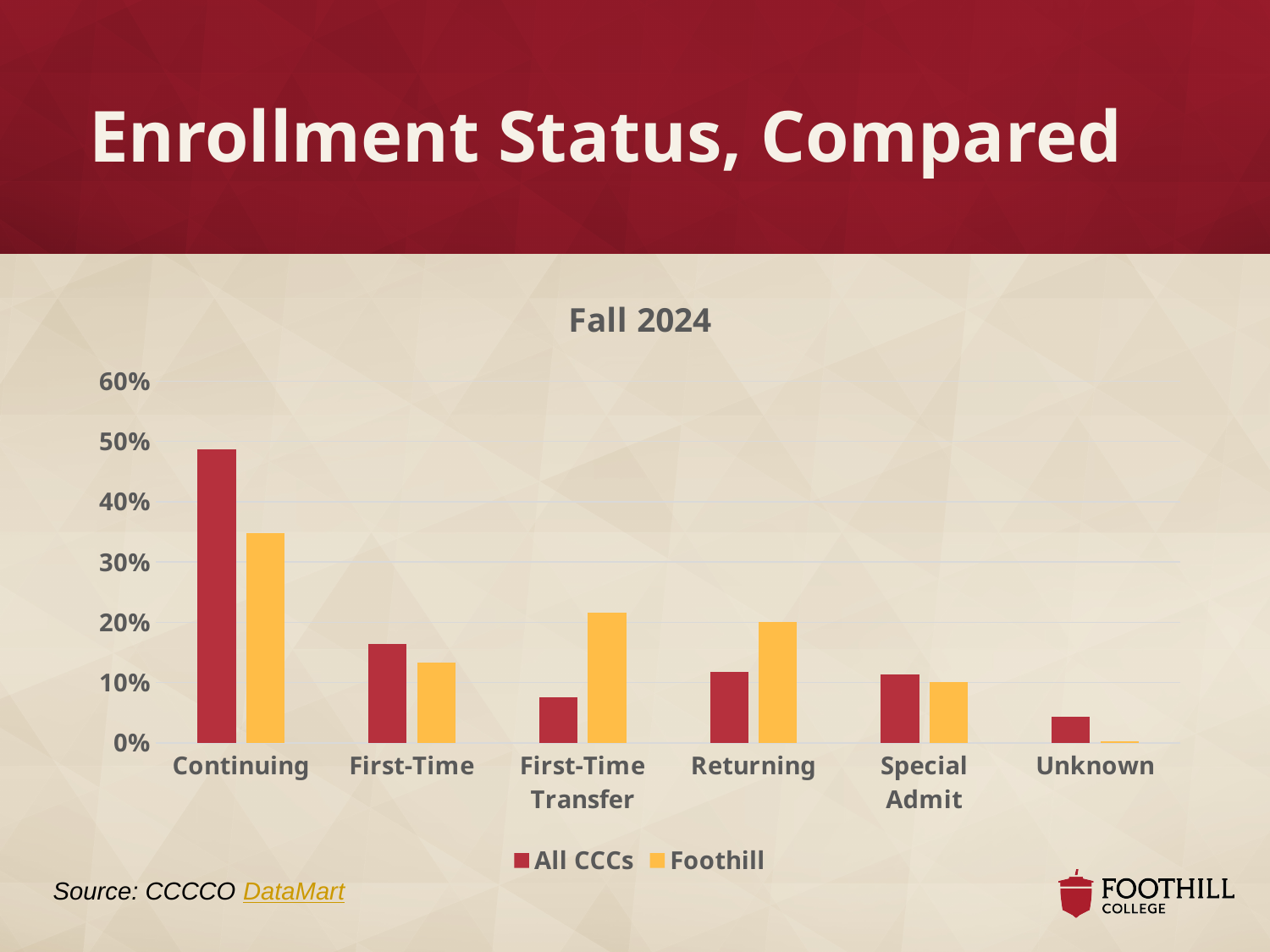
Which series is shown in yellow/orange bars? Foothill Is the All CCCs value for Unknown greater or less than 10%? less How many enrollment status categories are shown on the x axis? 6 For First-Time Transfer, which is larger: All CCCs or Foothill? Foothill For Continuing, which is larger: All CCCs or Foothill? All CCCs What is the title of the chart? Fall 2024 What kind of chart is shown on the slide? bar chart Is the All CCCs value for Continuing greater or less than 40%? greater Which category has the highest value for All CCCs? Continuing Is the Foothill value for Continuing greater or less than 30%? greater How many series does the legend list? 2 Which category has the lowest value for Foothill? Unknown